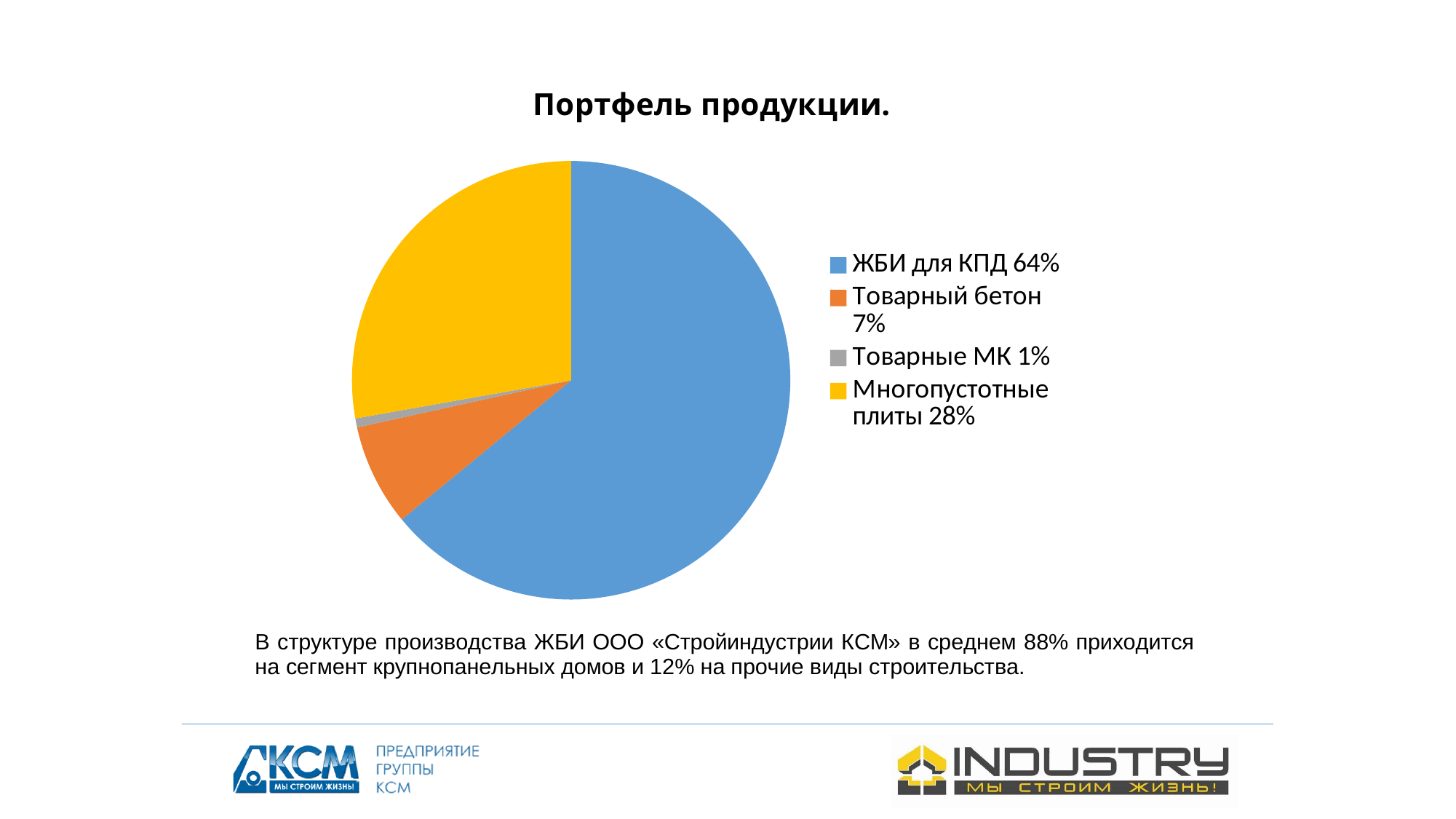
What kind of chart is shown on the slide? pie chart What share of the pie is ЖБИ для КПД? 64% What share of the pie is Товарные МК? 1% What share of the pie is Многопустотные плиты? 28% Which is larger, the share for Товарный бетон or the share for Многопустотные плиты? Многопустотные плиты What is the title of the chart? Портфель продукции. What is the difference in percentage points between ЖБИ для КПД and Многопустотные плиты? 36 Which category has the smallest share of the pie? Товарные МК Which category has the largest share of the pie? ЖБИ для КПД What colour is the slice for Многопустотные плиты? yellow How many slices does the pie chart have? 4